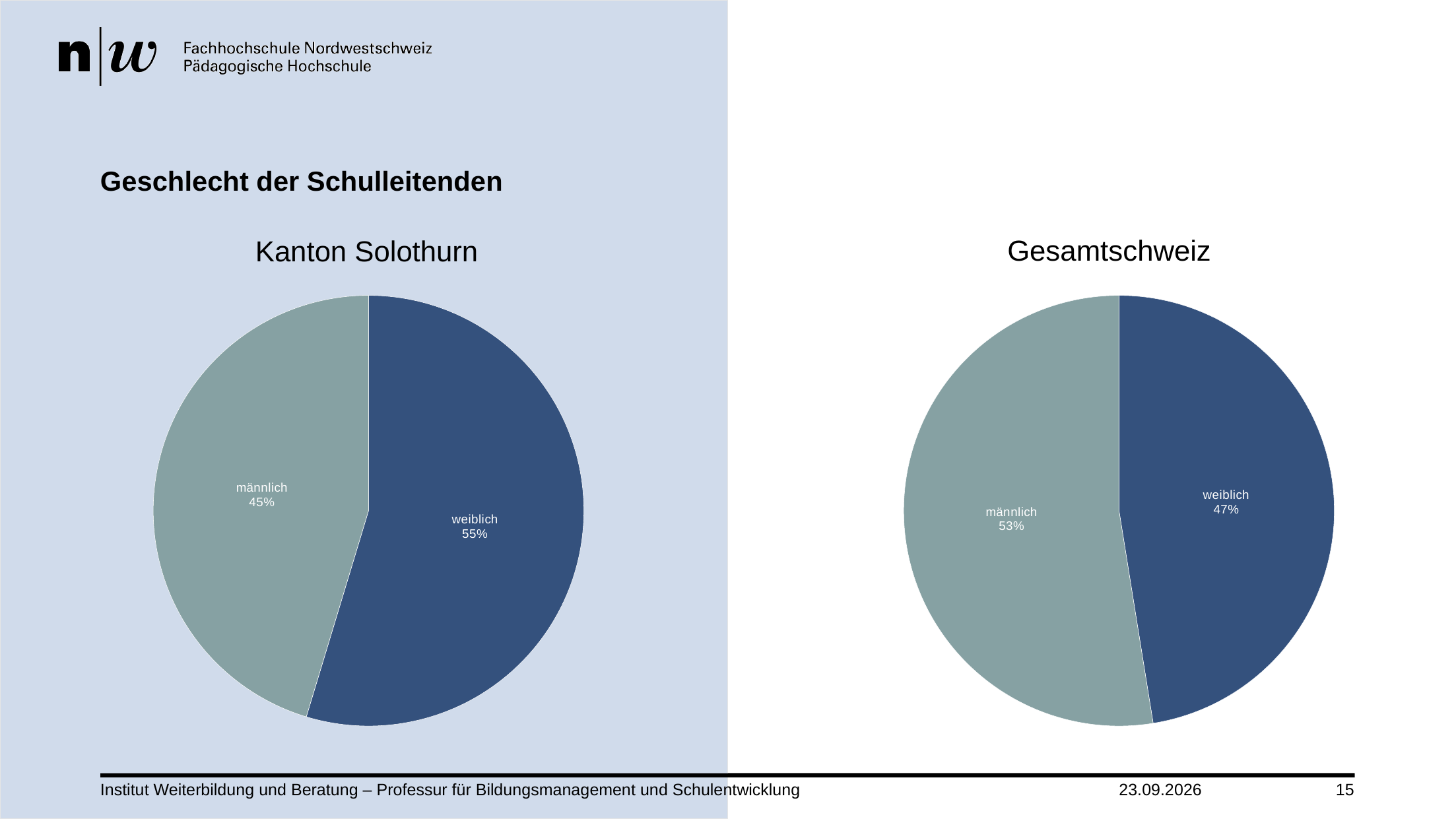
Is the weiblich share larger in the Kanton Solothurn chart or in the Gesamtschweiz chart? Kanton Solothurn What is the title of the slide above the two charts? Geschlecht der Schulleitenden In the Gesamtschweiz chart, what is the difference in percentage points between männlich and weiblich? 6 What kind of chart is the Kanton Solothurn chart? pie chart How many slices does the Gesamtschweiz chart have? 2 In the Gesamtschweiz chart, what share is labelled for männlich? 53% In the Kanton Solothurn chart, what share is labelled for weiblich? 55% In the Kanton Solothurn chart, what is the difference in percentage points between weiblich and männlich? 10 In the Kanton Solothurn chart, what share is labelled for männlich? 45% In the Gesamtschweiz chart, what share is labelled for weiblich? 47% In the Kanton Solothurn chart, which slice is the largest? weiblich In the Gesamtschweiz chart, which slice is the smallest? weiblich